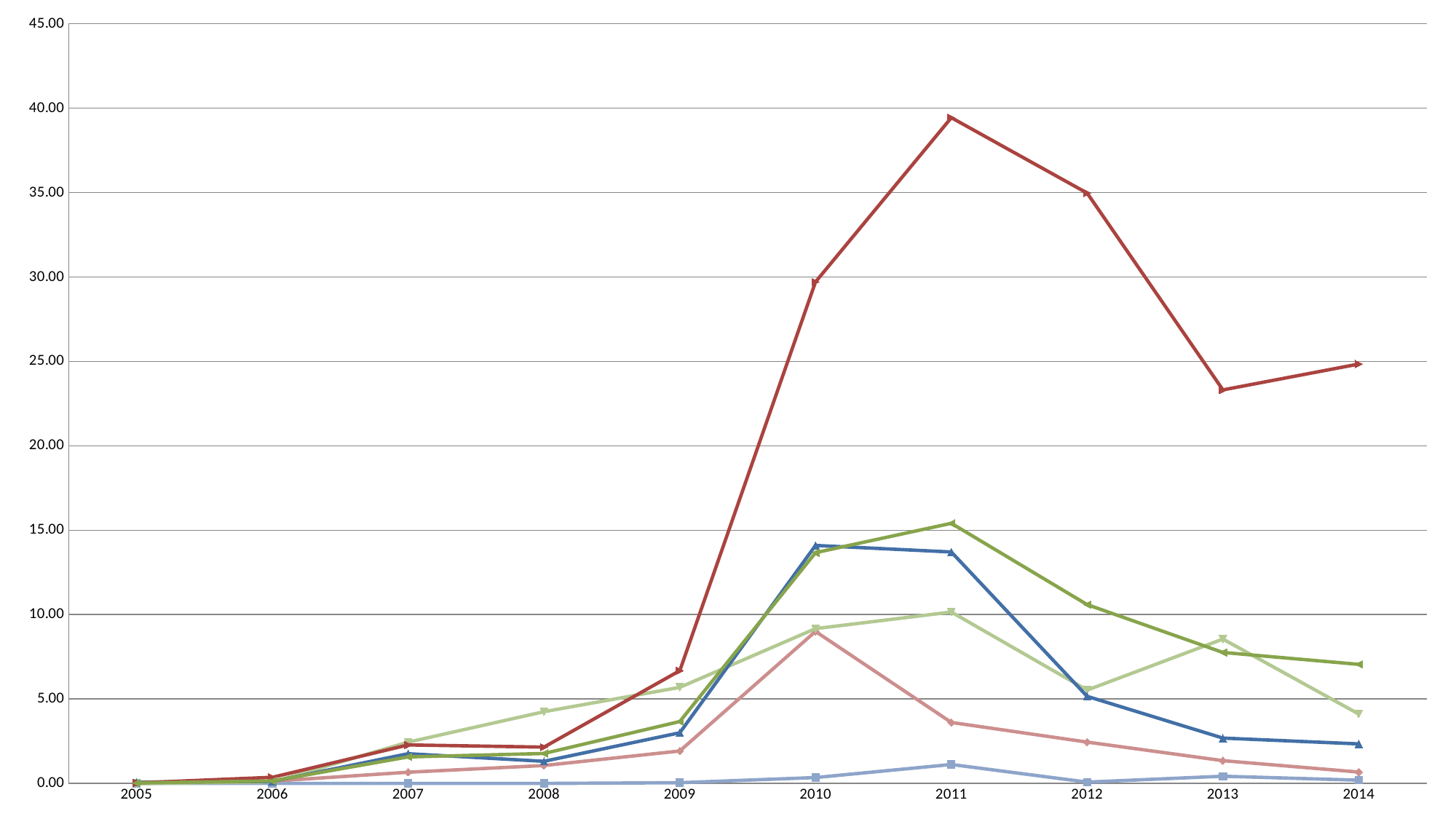
Is the value of the dark green line in 2014 greater or less than 5.00? greater Which line has the highest value in 2011? the dark red line What is the highest value shown on the y axis? 45.00 Is the value of the dark red line in 2013 greater or less than 25.00? less In which year does the dark red line reach its highest value? 2011 Is the value of the dark blue line in 2012 greater or less than 10.00? less What kind of chart is shown on the slide? line chart Does the dark red line rise or fall between 2011 and 2013? fall In 2010, which is larger: the dark blue line or the light green line? the dark blue line How many years are shown along the x axis? 10